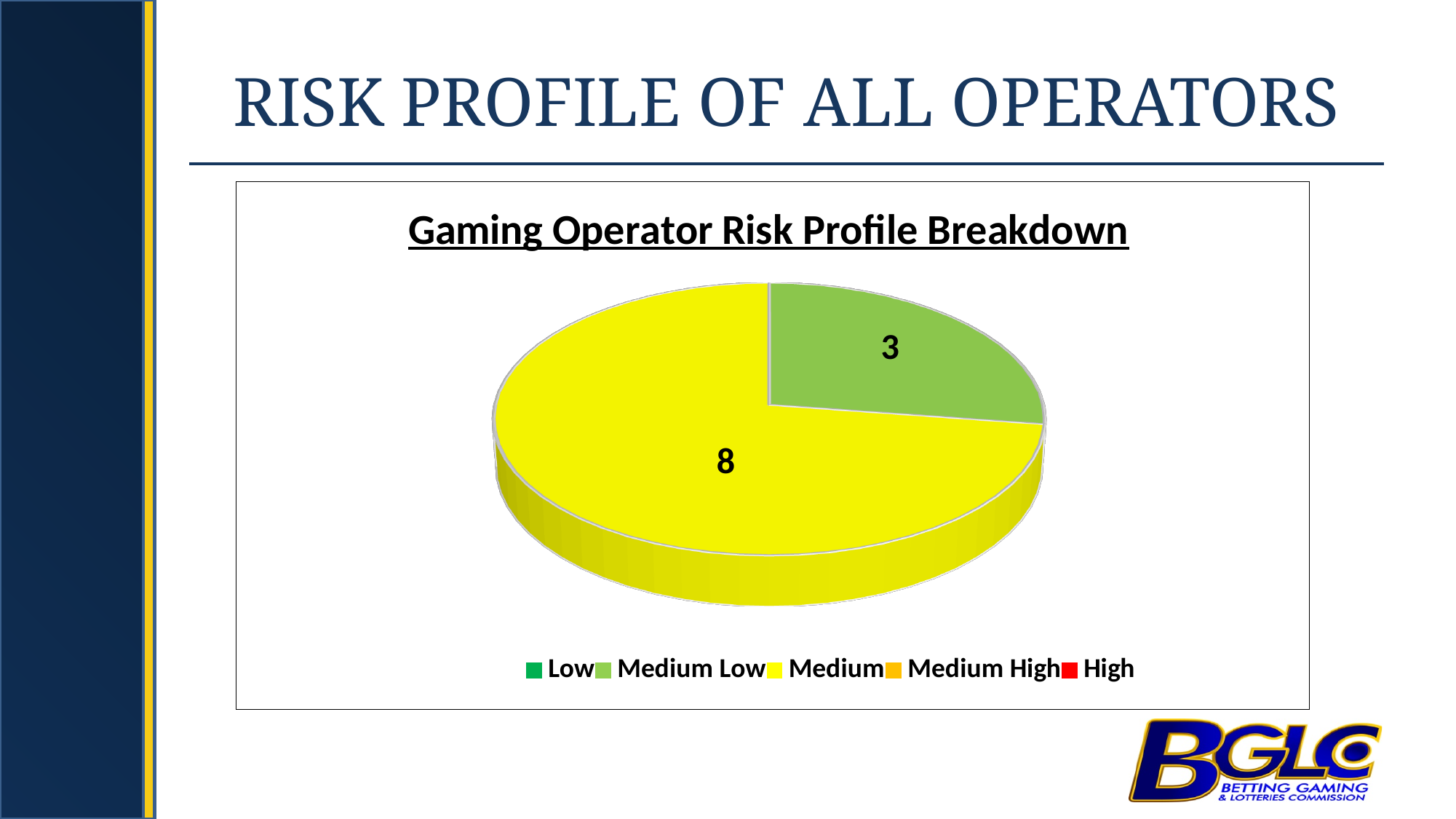
What is the total of the two labelled slices? 11 What is the difference between the Medium and Medium Low values? 5 How many categories does the legend list? 5 What is the value of the Medium Low slice? 3 What kind of chart is shown on the slide? pie chart What colour is the Medium slice? yellow Which is larger, the Medium slice or the Medium Low slice? Medium How many slices with data labels are shown in the pie? 2 What is the value of the Medium slice? 8 Which risk category has the largest slice? Medium Which of the two plotted risk categories has the smaller slice? Medium Low What is the title of the chart? Gaming Operator Risk Profile Breakdown